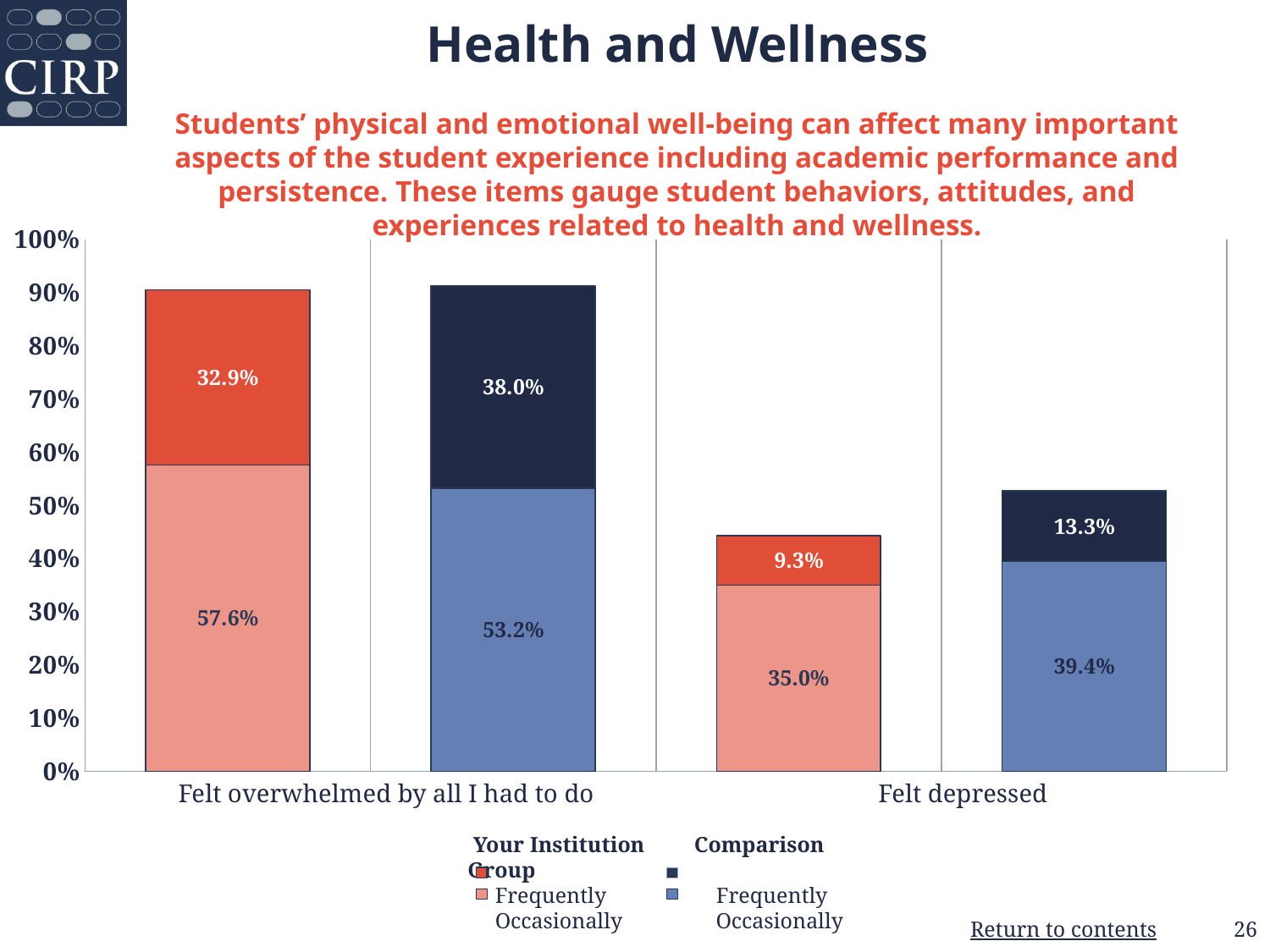
What is the total percentage of students at Your Institution who felt depressed either frequently or occasionally? 44.3% What percentage of students in the Comparison Group reported 'Occasionally' feeling depressed? 39.4% What percentage of students at Your Institution reported 'Occasionally' feeling overwhelmed by all they had to do? 57.6% What kind of chart is shown on the slide? Stacked bar chart Which is larger: the 'Occasionally' felt depressed percentage for Your Institution or for the Comparison Group? Comparison Group What is the total percentage of students in the Comparison Group who felt overwhelmed by all they had to do either frequently or occasionally? 91.2% What is the difference between the Comparison Group and Your Institution in the percentage of students who 'Frequently' felt overwhelmed by all they had to do? 5.1% How many categories are shown on the x axis of the chart? 2 What percentage of students at Your Institution reported 'Frequently' feeling overwhelmed by all they had to do? 32.9% Which segment has the lowest value on the chart? Your Institution, Frequently felt depressed (9.3%) Is the total stacked bar for Your Institution for 'Felt overwhelmed by all I had to do' greater or less than 80%? greater What percentage of students in the Comparison Group reported 'Frequently' feeling depressed? 13.3%